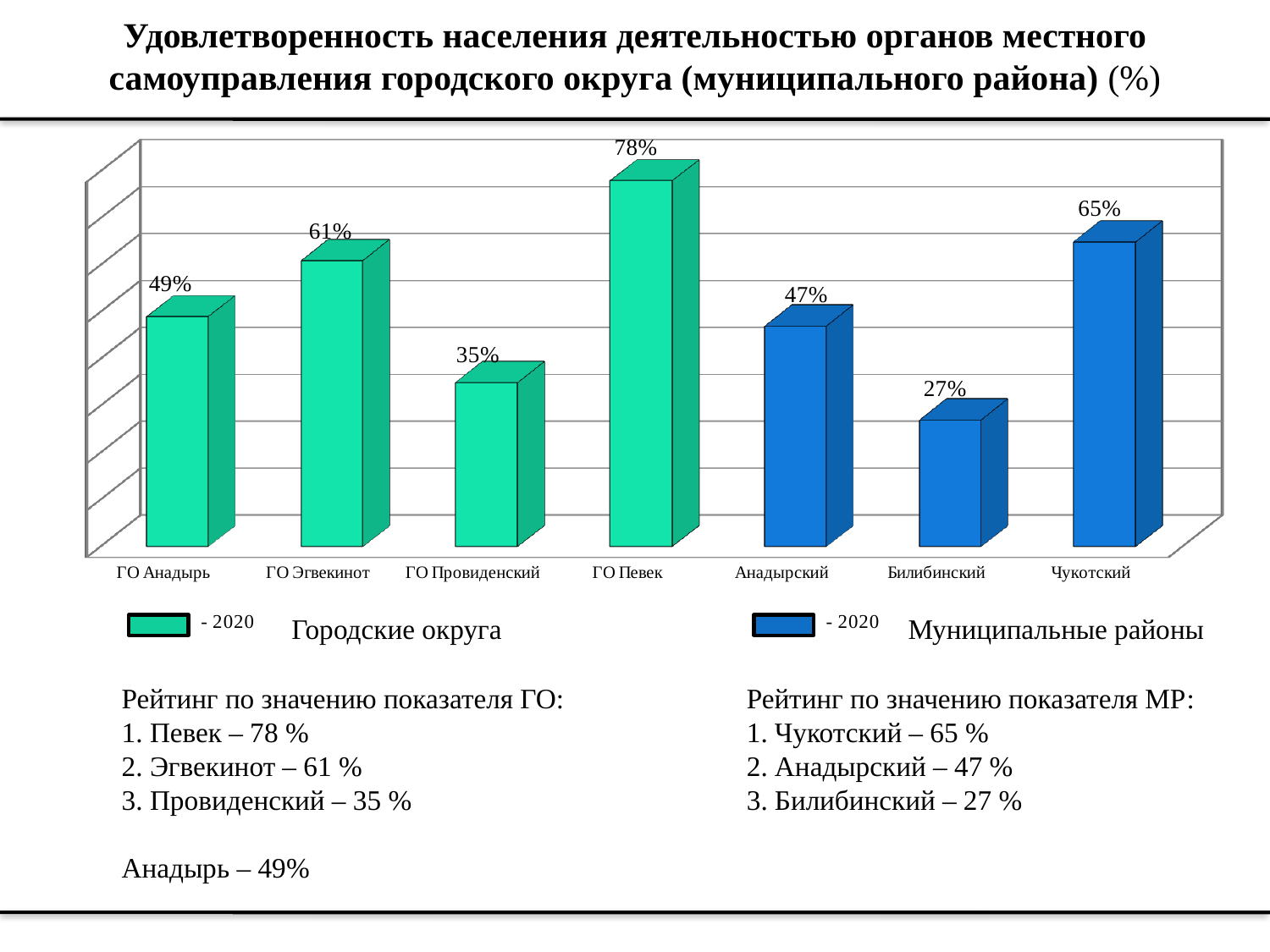
How many categories are shown on the chart? 7 What is the difference between the values for ГО Певек and Чукотский? 13% Which category has the highest value? ГО Певек What kind of chart is shown on the slide? bar chart What is the value for ГО Певек? 78% Which category has the lowest value? Билибинский What year do the legend entries refer to? 2020 Which is larger, the value for Чукотский or the value for Анадырский? Чукотский What is the value for Билибинский? 27% What is the value for ГО Анадырь? 49% What colour are the bars for the municipal districts (Муниципальные районы)? blue What is the difference between the values for ГО Эгвекинот and ГО Провиденский? 26%